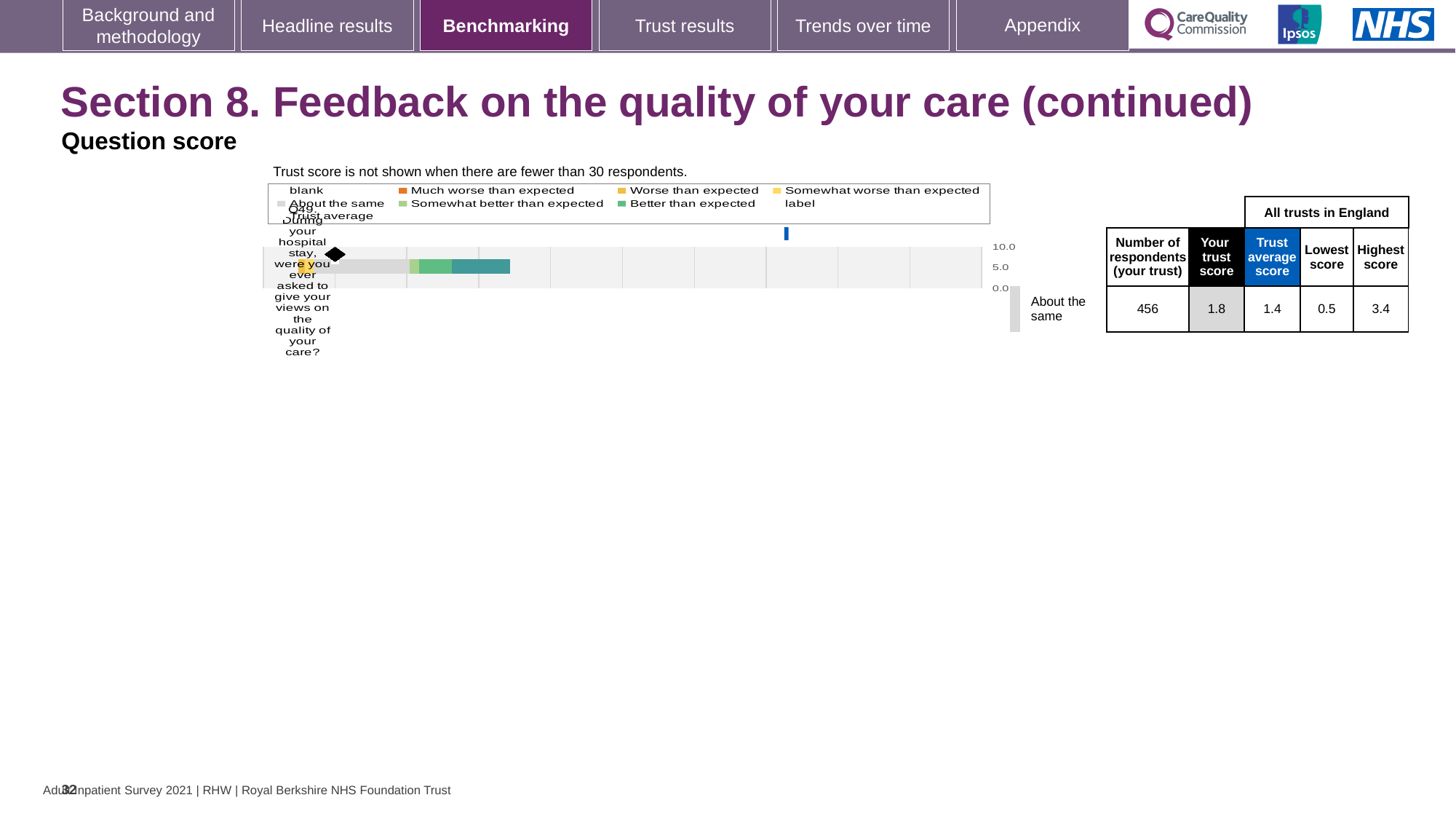
What is the highest score across all trusts in England for Q49? 3.4 How many questions are plotted in the benchmarking chart? 1 What is the 'Your trust score' value for Q49? 1.8 What is the difference between the highest score and the lowest score for Q49? 2.9 Which is larger for Q49, your trust score or the trust average score? Your trust score What is the lowest score across all trusts in England for Q49? 0.5 Which question number is plotted in the benchmarking chart? Q49 What kind of chart is used to show the Q49 benchmarking result? bar chart How many respondents from your trust answered Q49? 456 What benchmark category is shown next to the Q49 bar? About the same What is the difference between your trust score and the trust average score for Q49? 0.4 What is the 'Trust average score' for Q49? 1.4